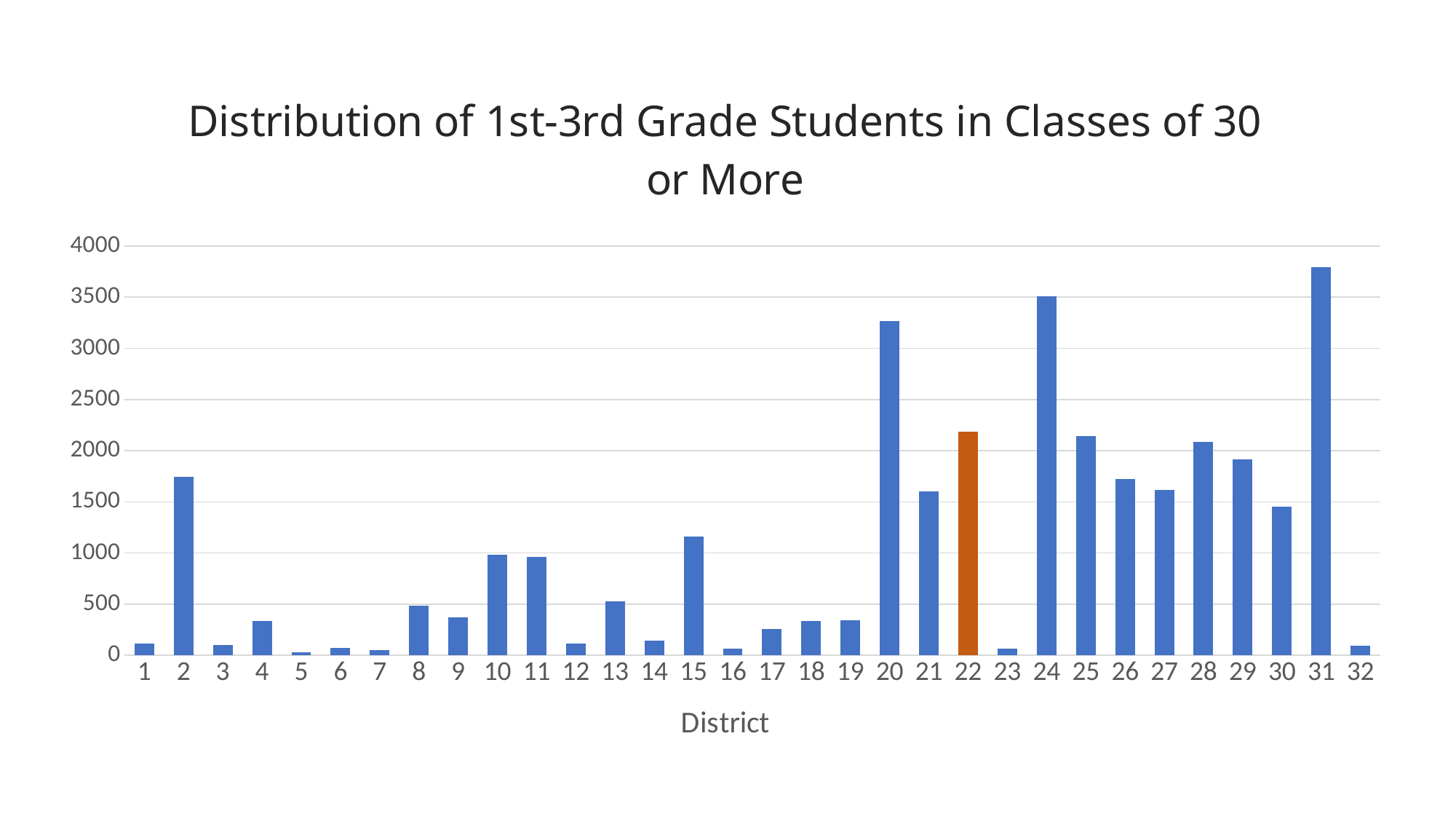
Is the value for district 30 greater or less than 1500? less What is the title of the chart? Distribution of 1st-3rd Grade Students in Classes of 30 or More Is the value for district 2 greater or less than 1500? greater How many districts are shown on the x axis of the chart? 32 What kind of chart is shown on the slide? bar chart Which district's bar is highlighted in orange rather than blue? 22 Which district has the larger value, district 10 or district 15? 15 Which district has the highest number of 1st-3rd grade students in classes of 30 or more? 31 Is the value for district 22 greater or less than 2000? greater Which district has the larger value, district 20 or district 24? 24